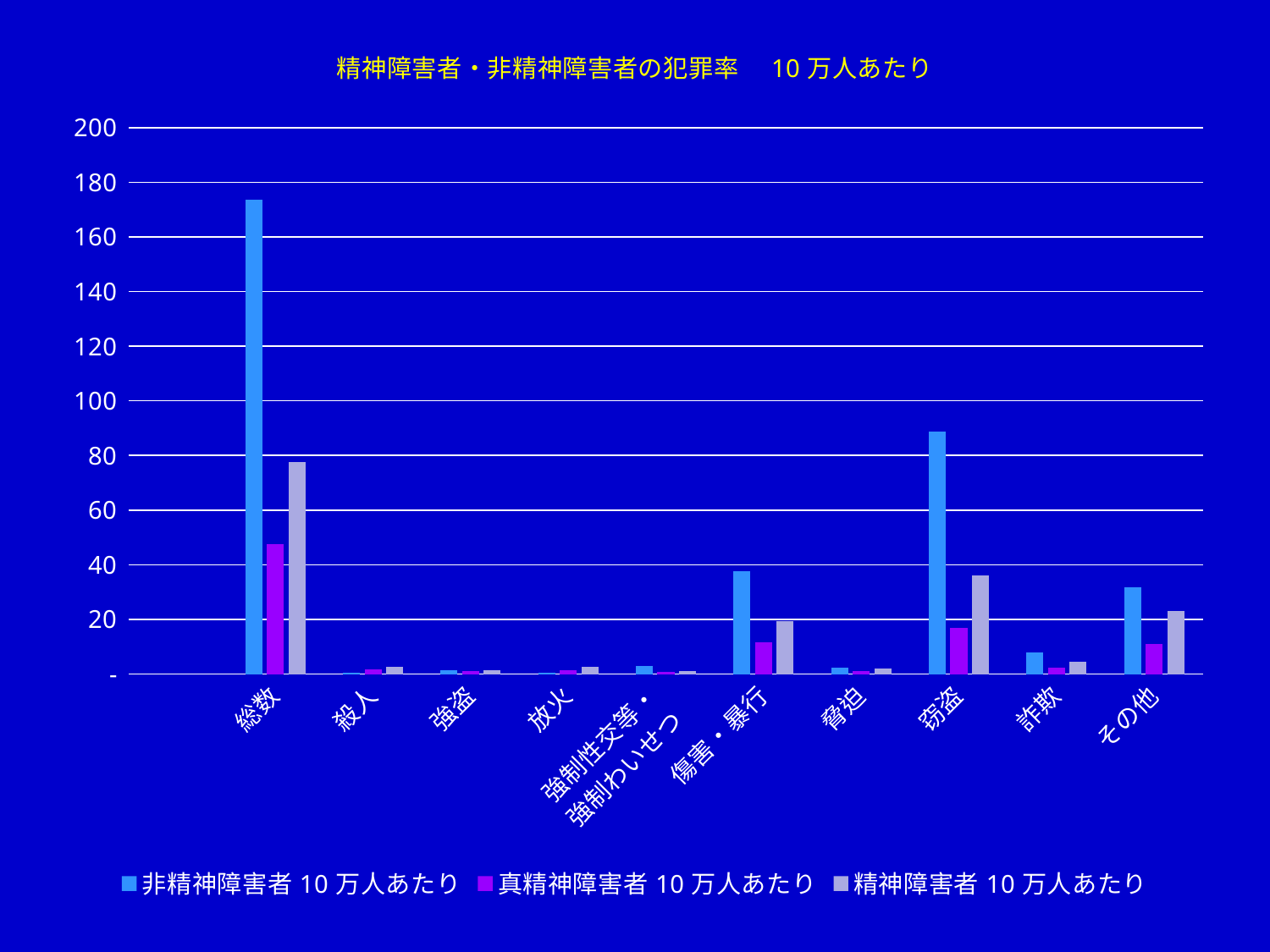
What is the title of the chart? 精神障害者・非精神障害者の犯罪率 10万人あたり Which category has the highest value for the 精神障害者 10万人あたり series? 総数 How many categories are shown along the x axis? 10 What kind of chart is shown on the slide? Bar chart Is the value for 総数 in the 非精神障害者 10万人あたり series greater or less than 160? greater Is the value for 総数 in the 真精神障害者 10万人あたり series greater or less than 40? greater In the 非精神障害者 10万人あたり series, which is larger: 窃盗 or 傷害・暴行? 窃盗 Is the value for 窃盗 in the 非精神障害者 10万人あたり series greater or less than 80? greater For 総数, which series has the larger value: 非精神障害者 10万人あたり or 精神障害者 10万人あたり? 非精神障害者 10万人あたり How many series does the legend list? 3 Which category has the highest value for the 非精神障害者 10万人あたり series? 総数